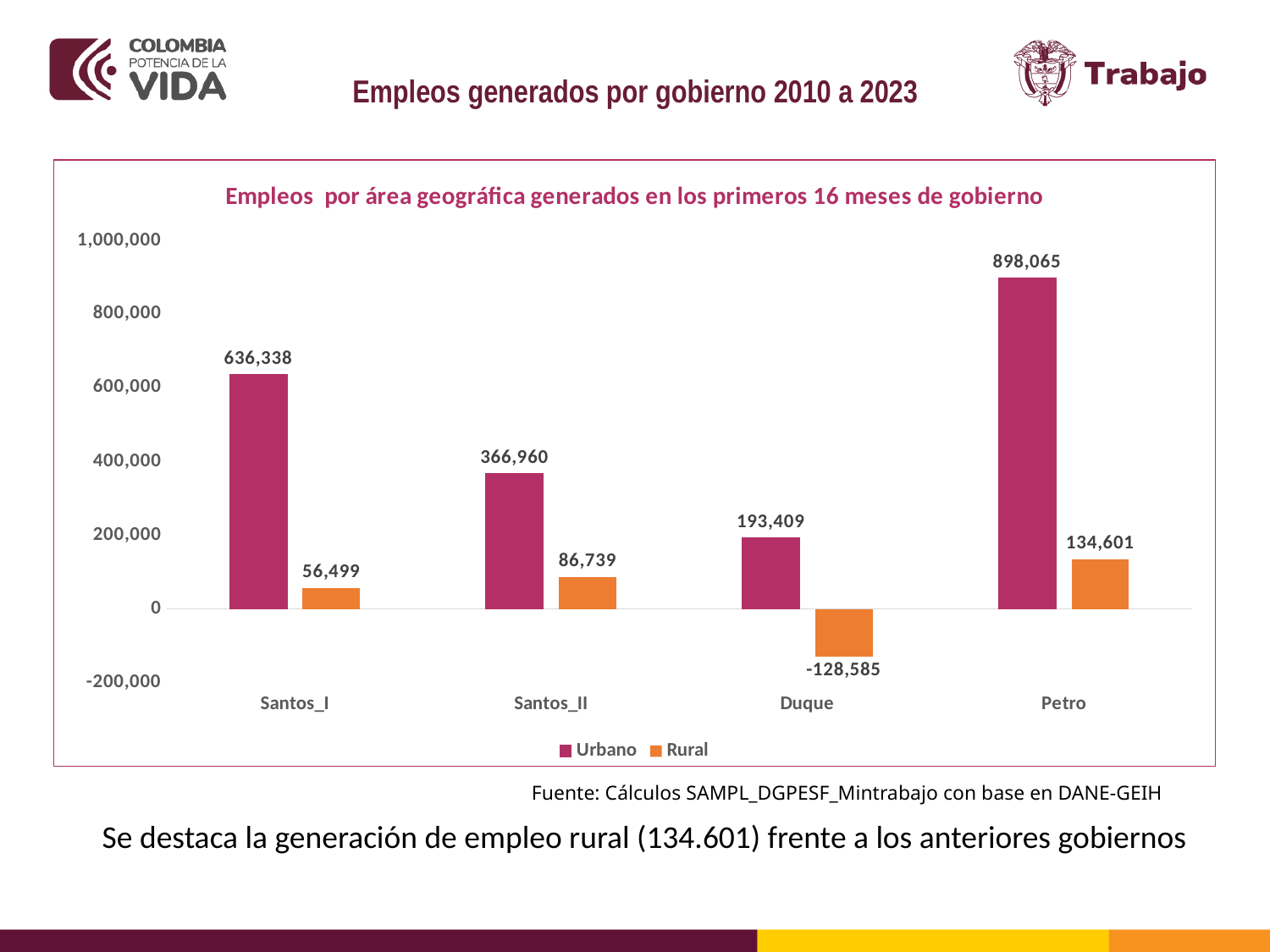
Which is larger, the Rural value for Santos_II or the Rural value for Petro? Petro What is the Rural value for Duque? -128,585 What kind of chart is shown? bar chart What is the Rural value for Santos_I? 56,499 Which government has the highest Urbano value? Petro What is the title of the chart? Empleos por área geográfica generados en los primeros 16 meses de gobierno Is the Urbano value for Duque greater or less than 200,000? less What is the Urbano value for Petro? 898,065 What is the difference between the Urbano values for Santos_I and Santos_II? 269,378 Which government has the lowest Rural value? Duque How many governments are shown on the x axis? 4 How many series does the legend list? 2